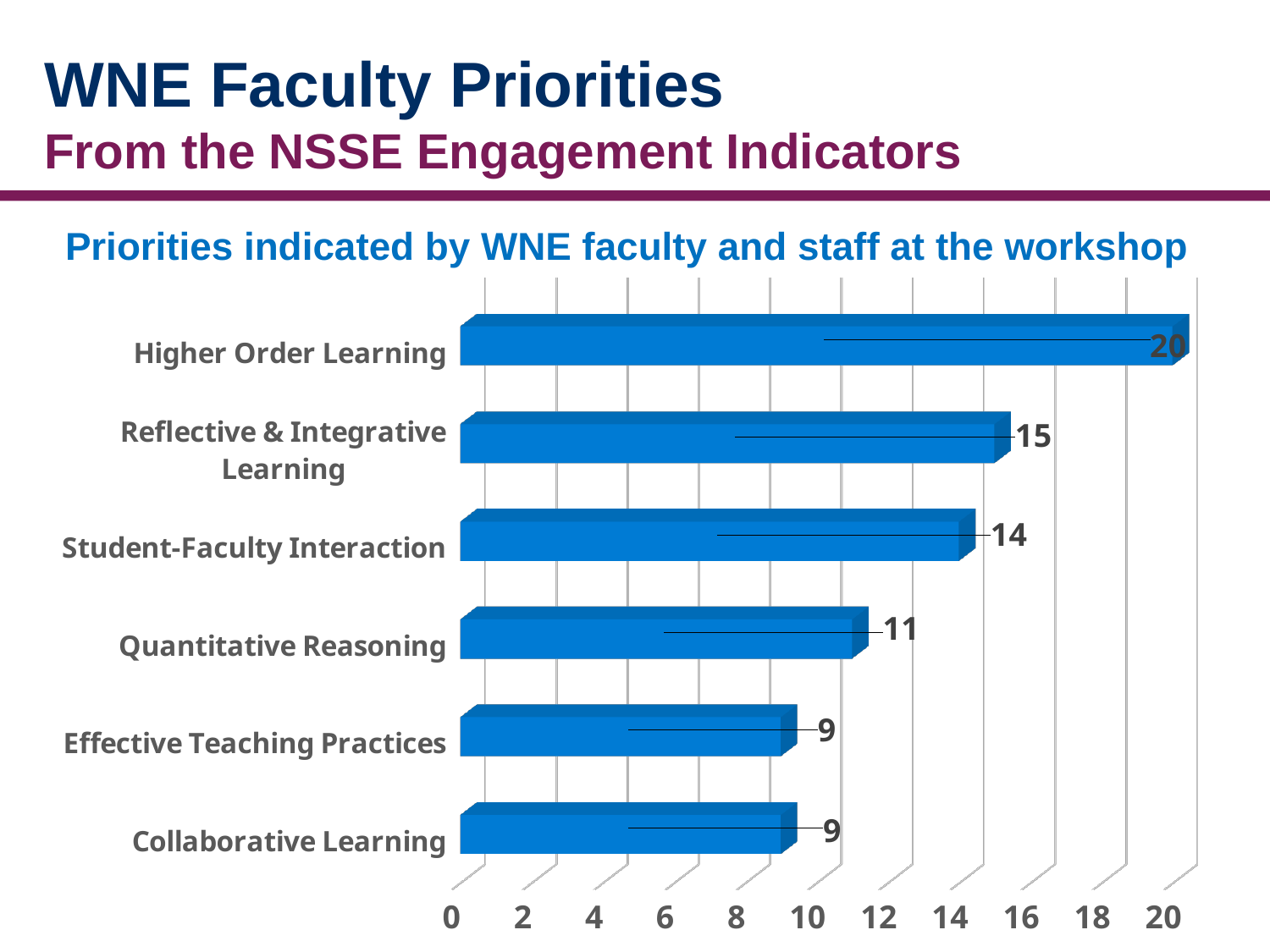
Which is larger, the value for Student-Faculty Interaction or the value for Quantitative Reasoning? Student-Faculty Interaction What is the value for Student-Faculty Interaction? 14 What is the value for Reflective & Integrative Learning? 15 What is the title of the chart? Priorities indicated by WNE faculty and staff at the workshop Is the value for Reflective & Integrative Learning greater or less than 10? greater What is the difference between the values for Quantitative Reasoning and Effective Teaching Practices? 2 What is the difference between the values for Higher Order Learning and Reflective & Integrative Learning? 5 How many categories are shown in the chart? 6 What is the value for Higher Order Learning? 20 What kind of chart is shown on the slide? bar chart Which category has the highest value? Higher Order Learning What is the value for Quantitative Reasoning? 11